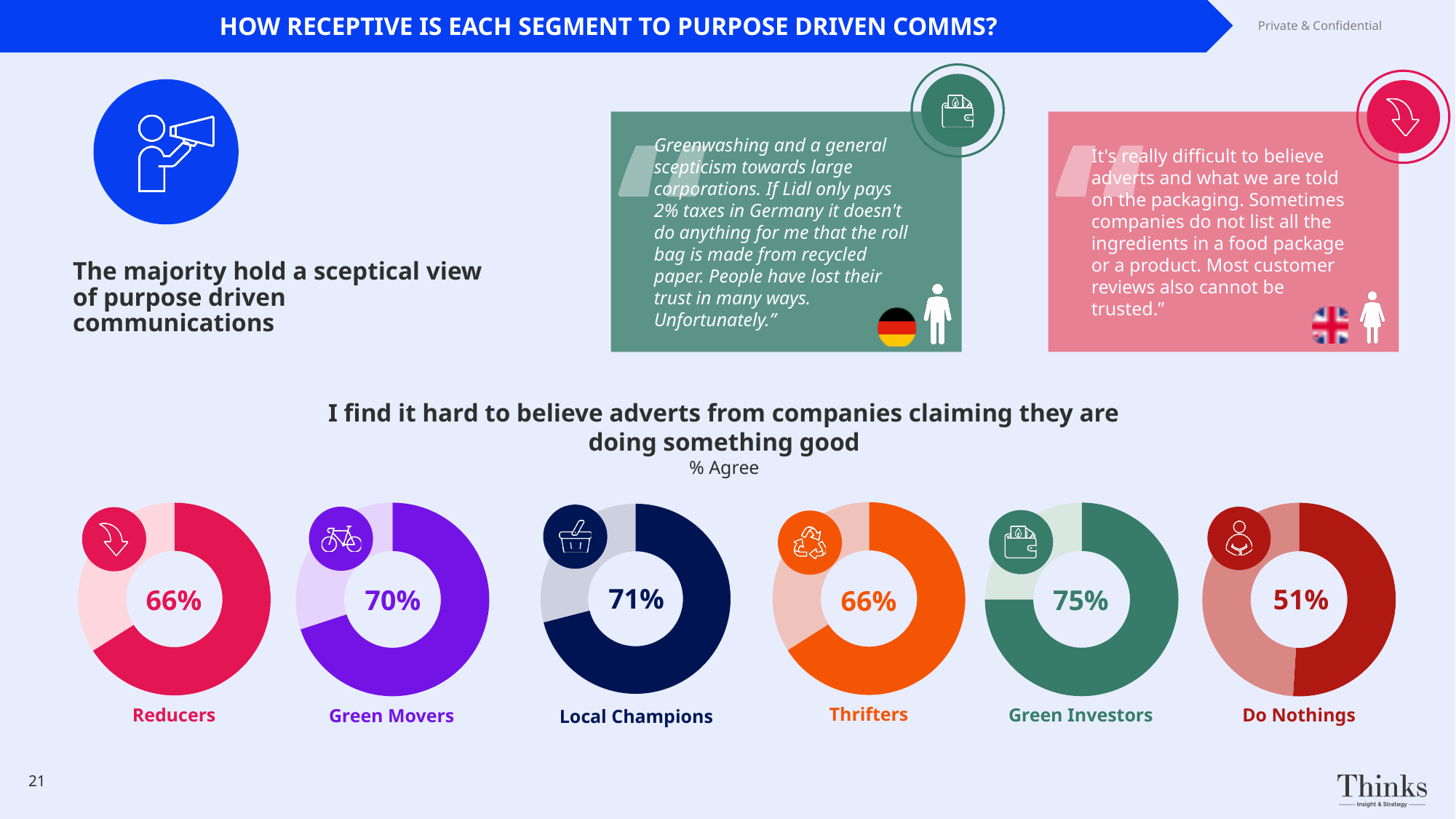
In the donut chart for Local Champions, what is the % Agree value shown? 71% Across the six donut charts under 'I find it hard to believe adverts from companies claiming they are doing something good', which segment has the highest % Agree? Green Investors In the donut chart for Do Nothings, what is the % Agree value shown? 51% In the donut chart for Green Investors, what is the % Agree value shown? 75% What is the difference in % Agree between the Green Movers donut chart and the Reducers donut chart? 4 percentage points How many segment donut charts are shown under the heading 'I find it hard to believe adverts from companies claiming they are doing something good'? 6 Across the six donut charts under 'I find it hard to believe adverts from companies claiming they are doing something good', which segment has the lowest % Agree? Do Nothings In the donut chart for Reducers, what percentage agree that they find it hard to believe adverts from companies claiming they are doing something good? 66% What is the difference in % Agree between the Green Investors donut chart and the Do Nothings donut chart? 24 percentage points Comparing the Local Champions and Thrifters donut charts, which segment has the higher % Agree? Local Champions In the donut chart for Green Movers, what is the % Agree value shown? 70% What type of chart is used to show the % Agree for each segment at the bottom of the slide? Donut chart